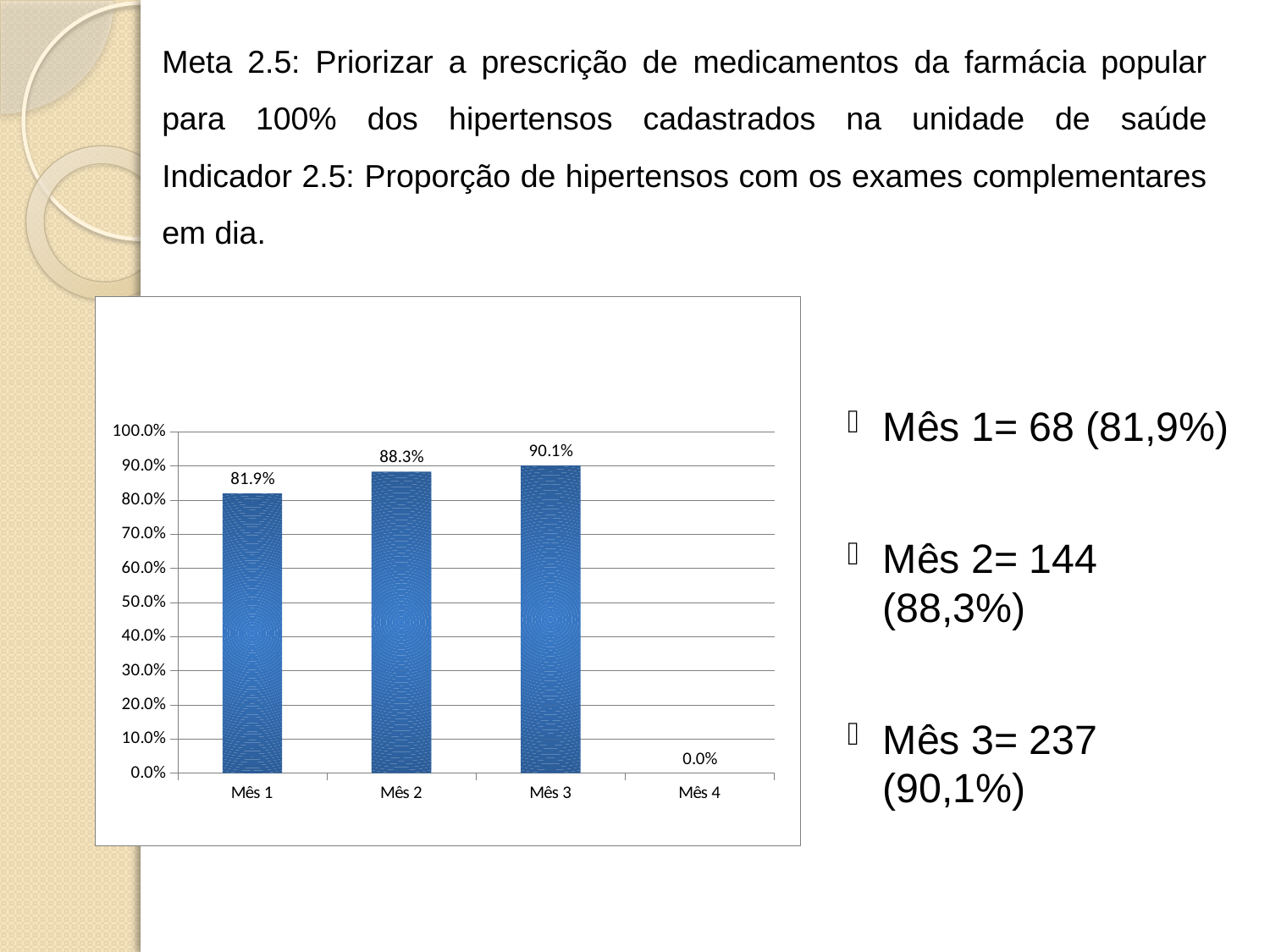
What kind of chart is shown on the slide? bar chart What is the value for Mês 1? 81.9% What is the value for Mês 4? 0.0% Which is larger, the value for Mês 2 or the value for Mês 3? Mês 3 Is the value for Mês 1 greater or less than 80.0%? greater What is the difference between the values for Mês 2 and Mês 1? 6.4% Do the values rise or fall from Mês 1 to Mês 3? rise Which category has the highest value? Mês 3 Which category has the lowest value? Mês 4 How many categories are shown on the x axis? 4 What is the difference between the values for Mês 3 and Mês 1? 8.2% What is the value for Mês 2? 88.3%